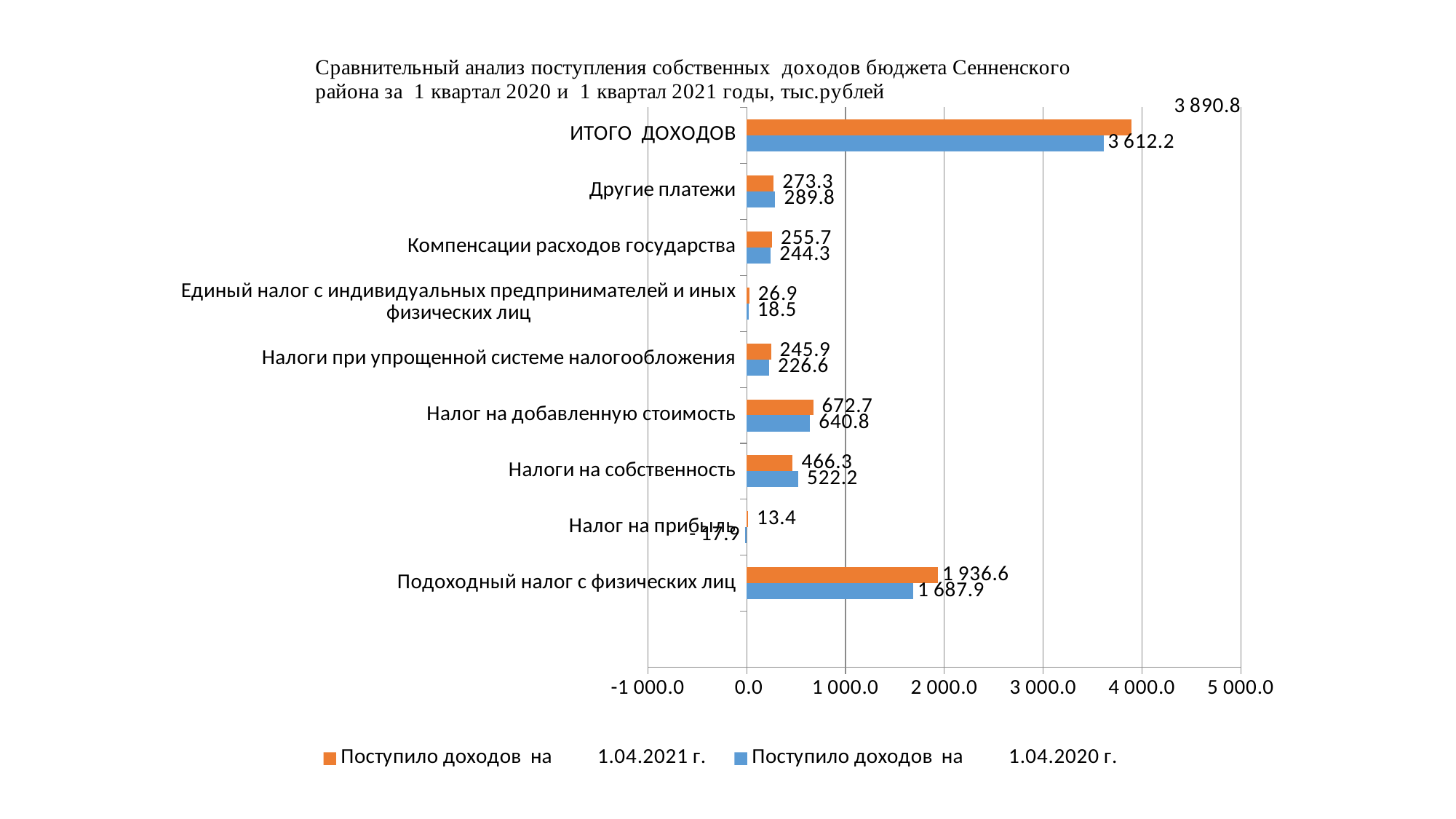
What kind of chart is shown on the slide? bar chart How many series does the legend list? 2 For Налоги на собственность, which series has the larger value: 1.04.2021 г. or 1.04.2020 г.? Поступило доходов на 1.04.2020 г. Excluding ИТОГО ДОХОДОВ, which category has the highest value in the series Поступило доходов на 1.04.2021 г.? Подоходный налог с физических лиц What is the value for Налог на добавленную стоимость in the series Поступило доходов на 1.04.2021 г.? 672.7 What is the value for Налоги на собственность in the series Поступило доходов на 1.04.2020 г.? 522.2 What is the value for ИТОГО ДОХОДОВ in the series Поступило доходов на 1.04.2021 г.? 3 890.8 What is the value for Подоходный налог с физических лиц in the series Поступило доходов на 1.04.2020 г.? 1 687.9 What is the difference between the 1.04.2021 and 1.04.2020 values for ИТОГО ДОХОДОВ? 278.6 Which colour represents the series Поступило доходов на 1.04.2020 г.? blue Which category has the lowest value in the series Поступило доходов на 1.04.2021 г.? Налог на прибыль Is the value for Подоходный налог с физических лиц in the series Поступило доходов на 1.04.2021 г. greater or less than 1 000.0? greater